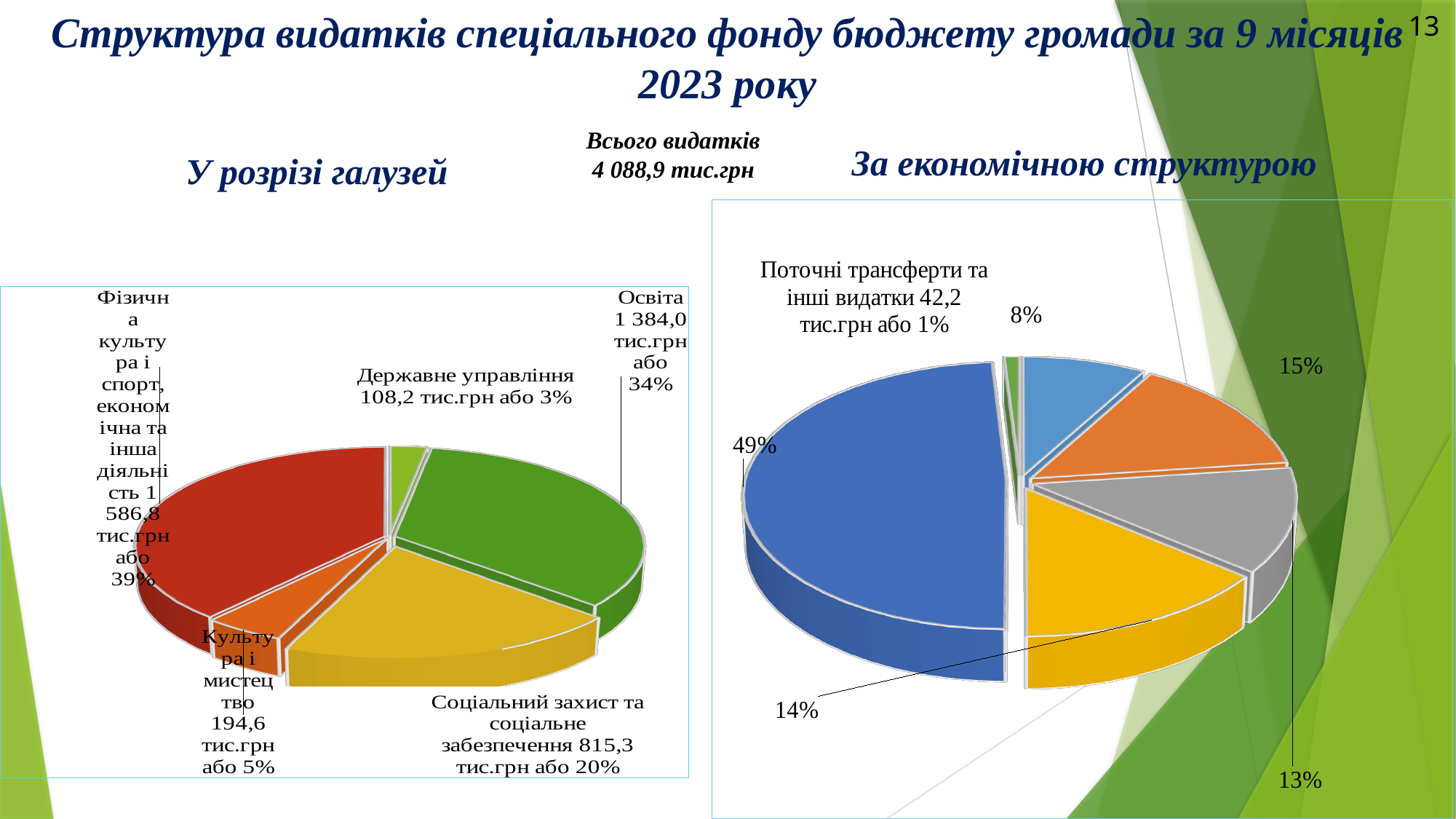
In the left chart 'У розрізі галузей', which category has the largest share? Фізична культура і спорт, економічна та інша діяльність In the left chart 'У розрізі галузей', what is the value for Державне управління? 108,2 тис.грн What type of chart is used on the left under 'У розрізі галузей'? Pie chart How many slices does the left chart 'У розрізі галузей' have? 5 In the right chart 'За економічною структурою', what share does Поточні трансферти та інші видатки have? 1% How many slices does the right chart 'За економічною структурою' have? 6 In the right chart 'За економічною структурою', what is the largest share shown? 49% In the left chart 'У розрізі галузей', what is the difference in percentage points between Освіта and Соціальний захист та соціальне забезпечення? 14 In the left chart 'У розрізі галузей', which is larger: Культура і мистецтво or Державне управління? Культура і мистецтво In the left chart 'У розрізі галузей', what share of the pie does Соціальний захист та соціальне забезпечення have? 20% In the left chart 'У розрізі галузей', what is the value for Освіта? 1 384,0 тис.грн In the left chart 'У розрізі галузей', which category has the smallest share? Державне управління